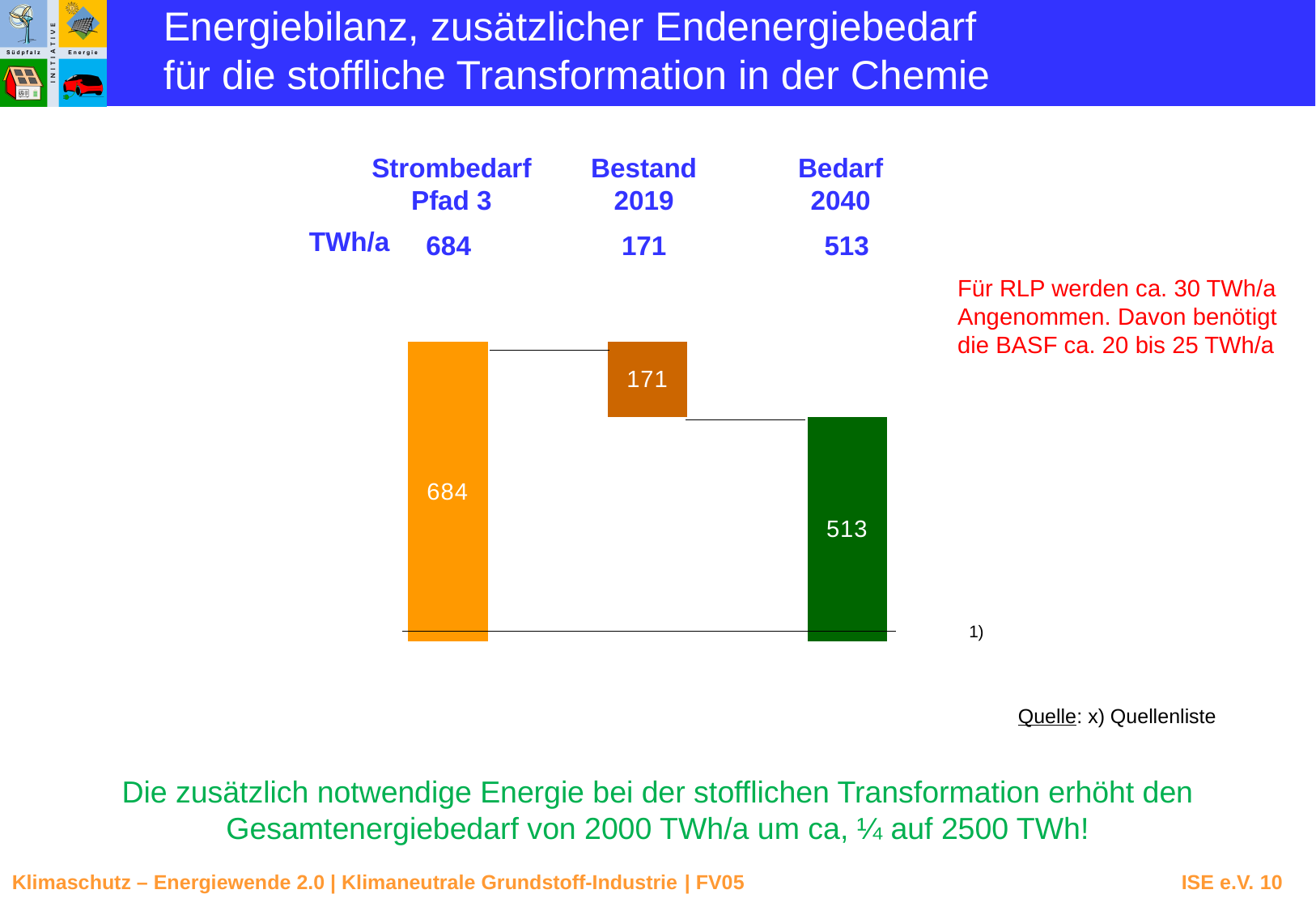
Which category has the highest value in the chart? Strombedarf Pfad 3 What is the value shown for Bedarf 2040 in the chart? 513 What kind of chart is shown on the slide? Bar chart (waterfall) What is the difference between Strombedarf Pfad 3 and Bedarf 2040? 171 What is the difference between Bedarf 2040 and Bestand 2019? 342 What is the value shown for Bestand 2019 in the chart? 171 How many bars are plotted in the chart? 3 What is the value shown for Strombedarf Pfad 3 in the chart? 684 What unit is given for the values in the chart? TWh/a Which category has the lowest value in the chart? Bestand 2019 What colour is the bar for Bedarf 2040? Dark green Which is larger, Bedarf 2040 or Bestand 2019? Bedarf 2040